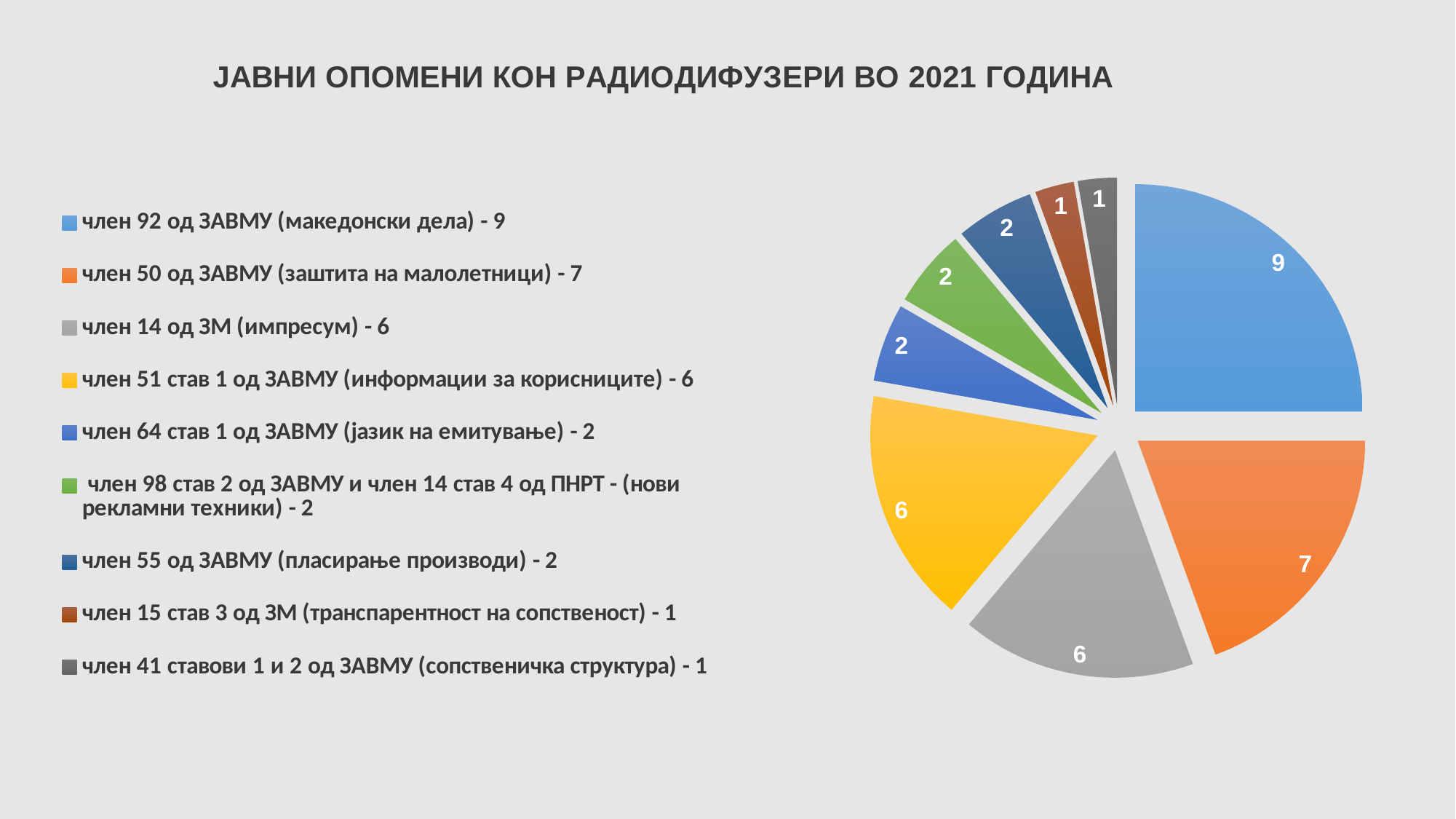
What is the title of the chart? ЈАВНИ ОПОМЕНИ КОН РАДИОДИФУЗЕРИ ВО 2021 ГОДИНА What is the difference between the values for член 92 од ЗАВМУ (македонски дела) and член 50 од ЗАВМУ (заштита на малолетници)? 2 What share of the pie does the slice for член 92 од ЗАВМУ (македонски дела) represent? 25% What kind of chart is shown on the slide? pie chart What is the value for член 64 став 1 од ЗАВМУ (јазик на емитување)? 2 Which is larger: the value for член 50 од ЗАВМУ (заштита на малолетници) or the value for член 14 од ЗМ (импресум)? член 50 од ЗАВМУ (заштита на малолетници) What is the value for член 50 од ЗАВМУ (заштита на малолетници)? 7 What colour is the slice for член 51 став 1 од ЗАВМУ (информации за корисниците)? yellow Which category has the largest slice of the pie? член 92 од ЗАВМУ (македонски дела) How many slices does the pie chart have? 9 What is the value for член 41 ставови 1 и 2 од ЗАВМУ (сопственичка структура)? 1 What is the value for член 92 од ЗАВМУ (македонски дела)? 9